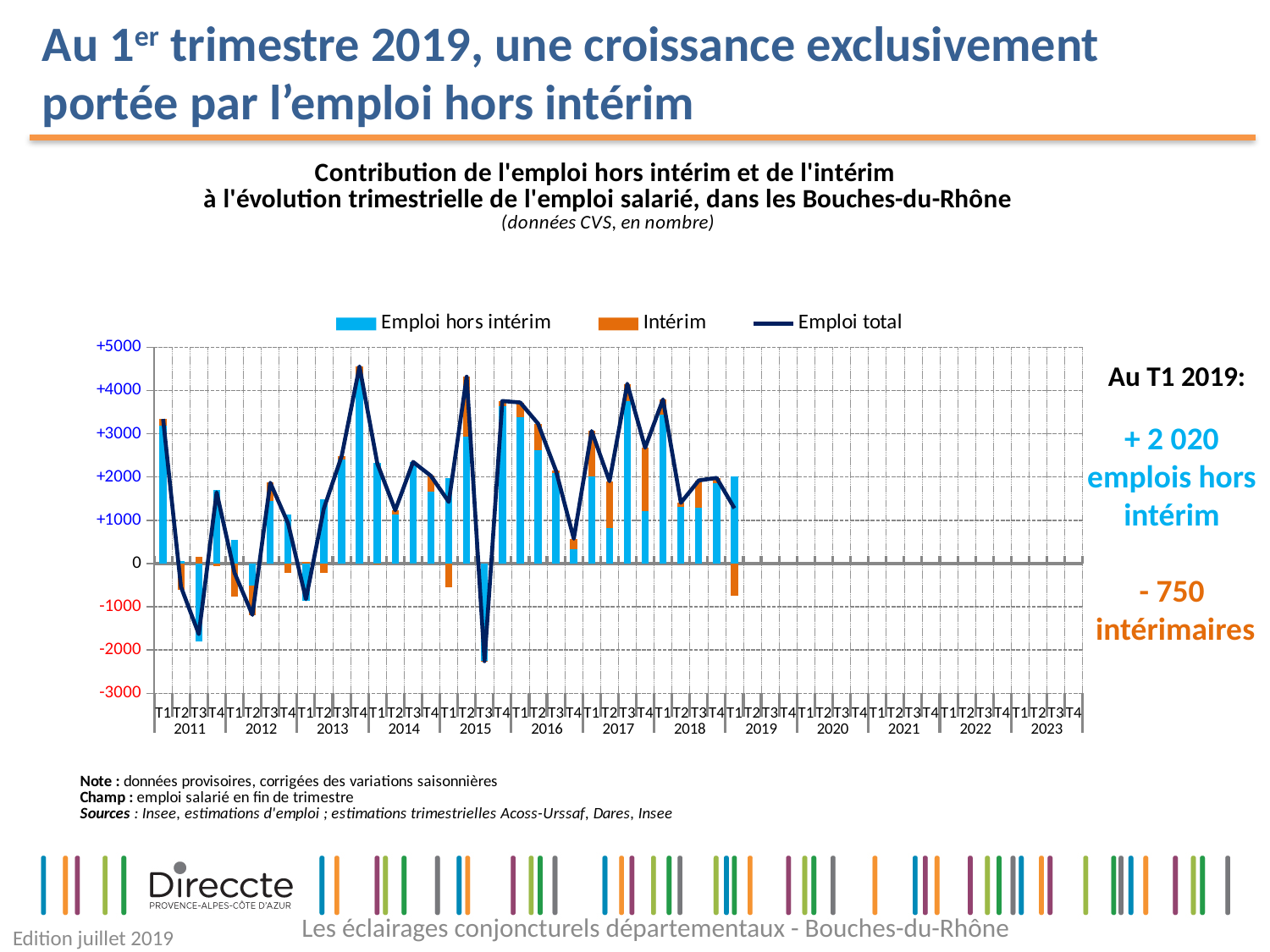
According to the slide, what is the value for Intérim at T1 2019? - 750 Is the value of Emploi total at T3 2015 greater or less than -1000? less What kind of chart is shown on the slide? bar chart with a line Is the value of Emploi total at T4 2013 greater or less than +4000? greater How many series does the chart legend list? 3 In which quarter does the Emploi total line reach its lowest value? T3 2015 What colour are the Intérim bars in the chart? orange According to the slide, what is the value for Emploi hors intérim at T1 2019? + 2 020 Is the value of Emploi total at T3 2011 greater or less than -1000? less Which is larger, the Emploi total value at T4 2013 or at T3 2011? T4 2013 How many years are labelled on the x axis of the chart? 13 What is the title of the chart? Contribution de l'emploi hors intérim et de l'intérim à l'évolution trimestrielle de l'emploi salarié, dans les Bouches-du-Rhône